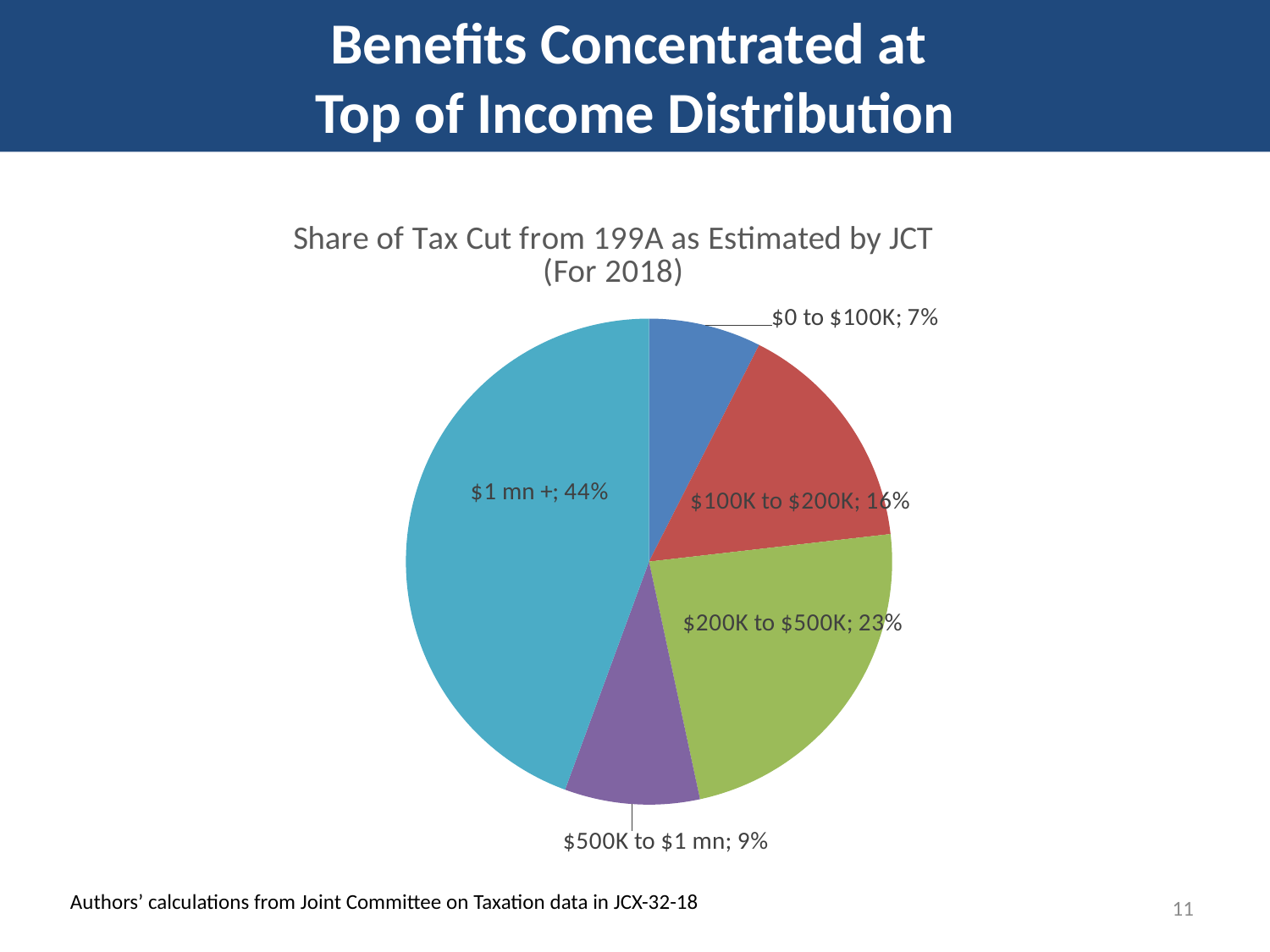
Which income group receives the largest share of the tax cut? $1 mn + What type of chart is shown on the slide? pie chart What share of the tax cut goes to the $0 to $100K income group? 7% How many income groups are shown in the pie chart? 5 What share of the tax cut goes to the $200K to $500K income group? 23% What is the difference in share between the $1 mn + group and the $200K to $500K group? 21 percentage points Which receives a larger share of the tax cut, the $100K to $200K group or the $500K to $1 mn group? $100K to $200K What share of the tax cut goes to the $100K to $200K income group? 16% What is the chart's title? Share of Tax Cut from 199A as Estimated by JCT (For 2018) Which income group receives the smallest share of the tax cut? $0 to $100K What share of the tax cut goes to the $1 mn + income group? 44% What share of the tax cut goes to the $500K to $1 mn income group? 9%